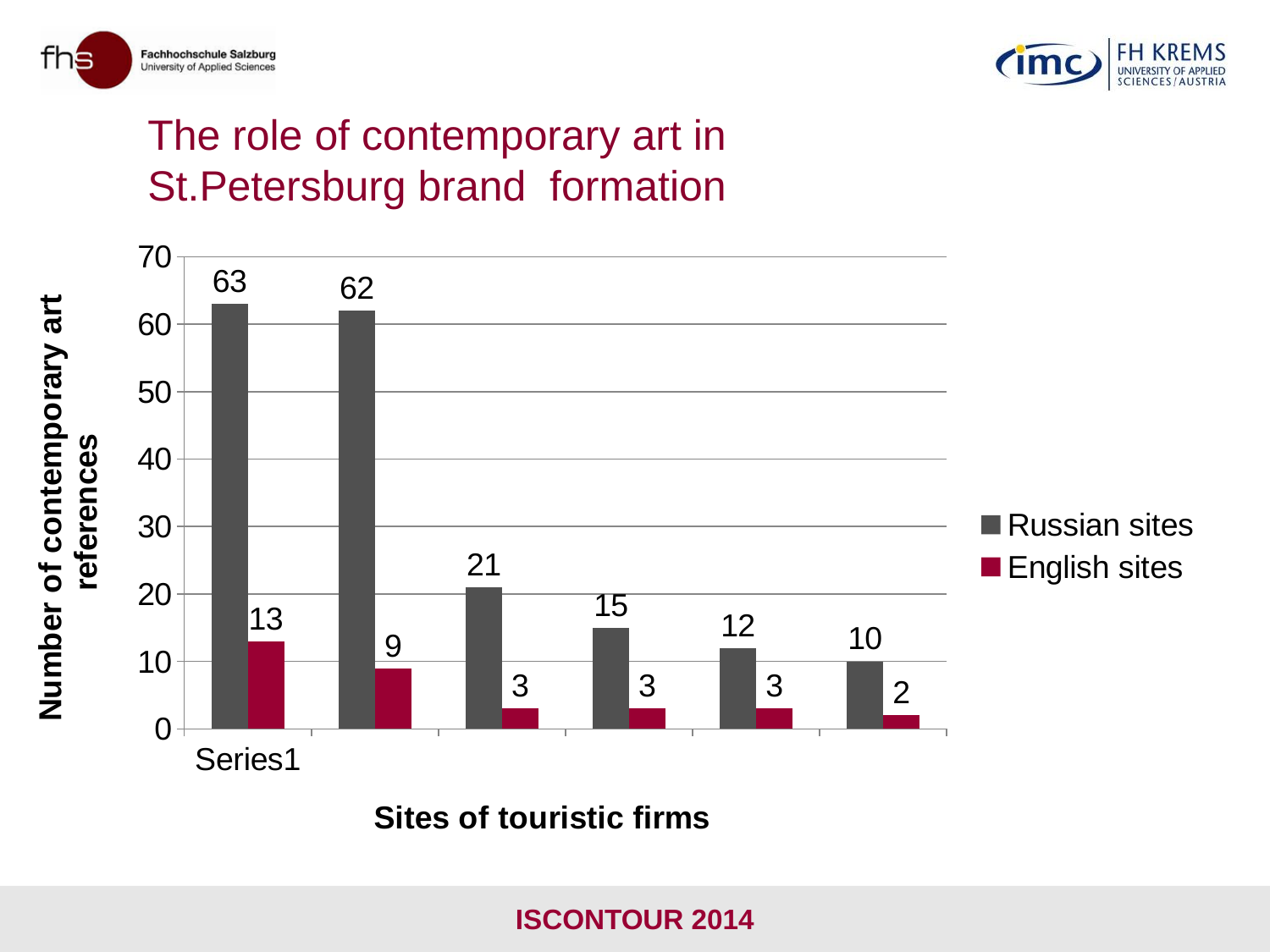
What is the value for English sites in the rightmost group of bars? 2 What is the highest value plotted for English sites? 13 What type of chart is shown on the slide? bar chart How many series does the legend list? 2 What is the difference between the Russian sites value and the English sites value in the first group (Series1)? 50 What is the value for Russian sites in the first group (Series1)? 63 What is the value for Russian sites in the rightmost group of bars? 10 What is the lowest value plotted for Russian sites? 10 What is the label of the y axis? Number of contemporary art references What is the value for English sites in the first group (Series1)? 13 How many groups of bars are plotted along the x axis? 6 Do the Russian sites values rise or fall from left to right along the x axis? fall